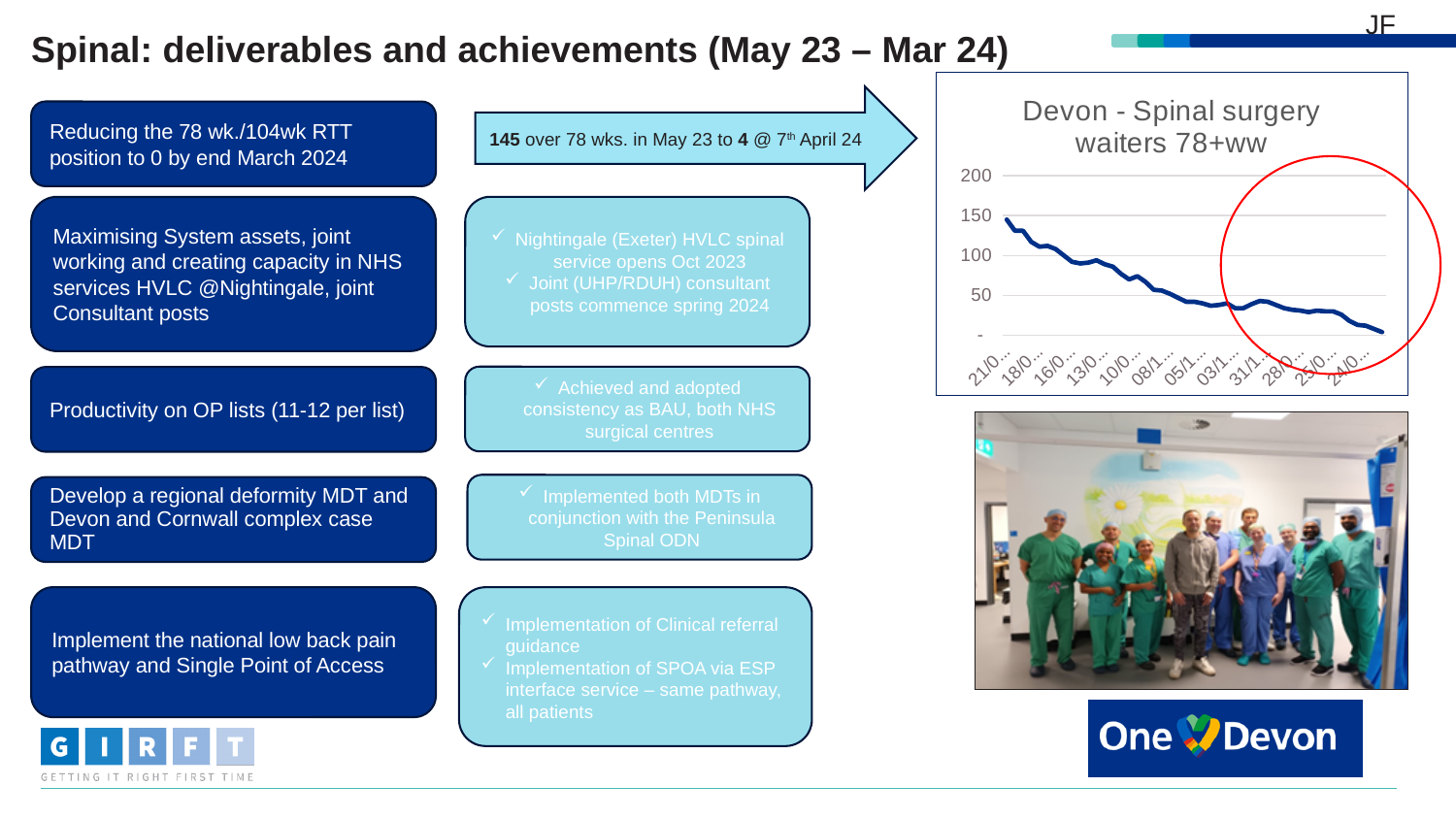
In the 'Devon - Spinal surgery waiters 78+ww' chart, is the value at the end of the line greater or less than 100? less What is the title of the chart on the slide? Devon - Spinal surgery waiters 78+ww What is the highest value shown on the y axis of the 'Devon - Spinal surgery waiters 78+ww' chart? 200 Do the values in the 'Devon - Spinal surgery waiters 78+ww' chart rise or fall over time along the x axis? fall In the 'Devon - Spinal surgery waiters 78+ww' chart, is the value at the end of the line greater or less than 50? less In the 'Devon - Spinal surgery waiters 78+ww' chart, is the value at the start of the line greater or less than 100? greater In the 'Devon - Spinal surgery waiters 78+ww' chart, which is larger: the value at the start of the line or the value at the end of the line? the value at the start What type of chart is shown on the slide? line chart